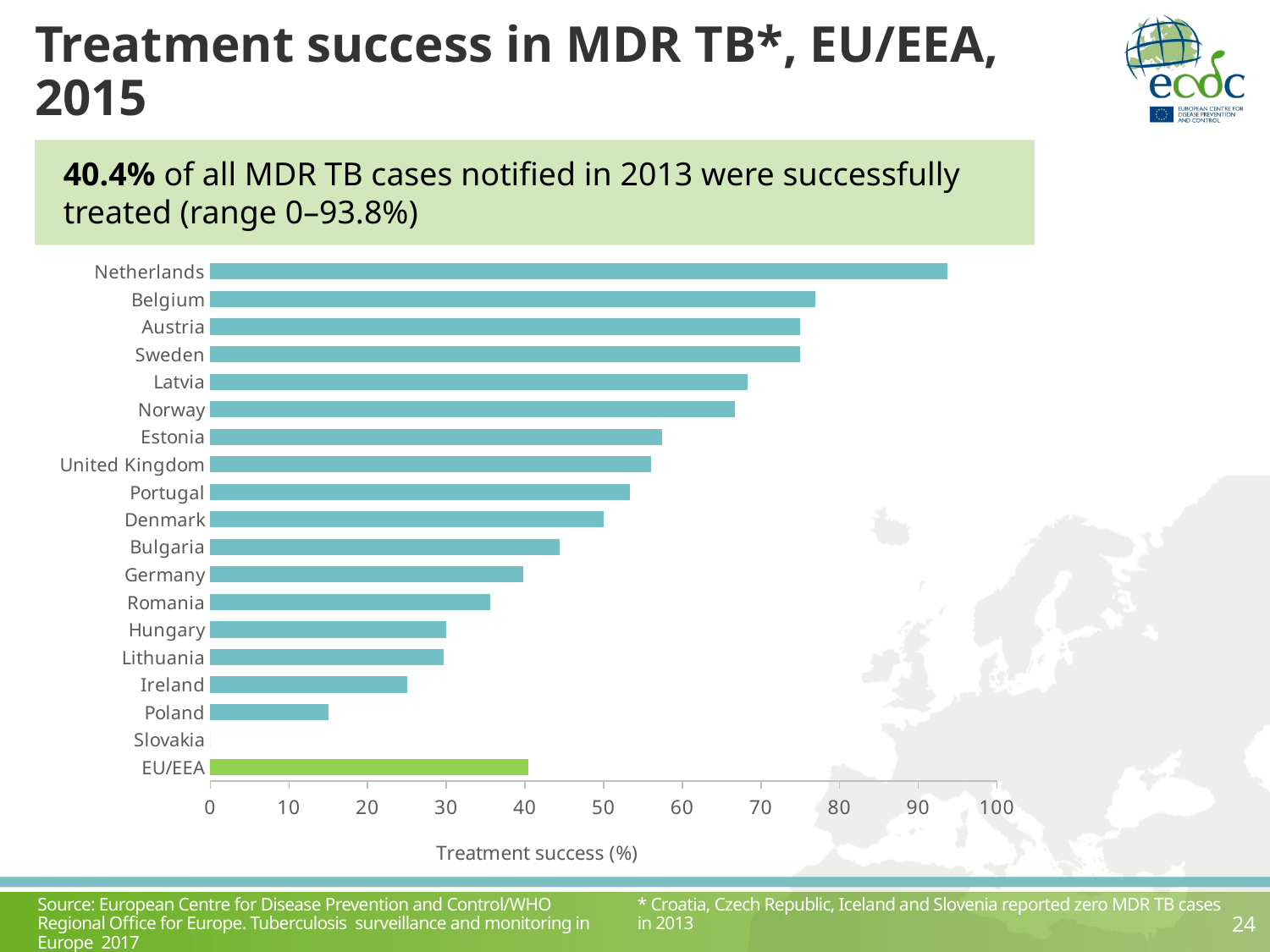
Which country has the lowest treatment success in the chart? Slovakia Which has a higher treatment success, Ireland or Poland? Ireland Is the treatment success value for Poland greater or less than 20? less What is the treatment success value for EU/EEA? 40.4% Is the treatment success value for Netherlands greater or less than 90? greater What is the title of the horizontal axis of the chart? Treatment success (%) Which country has the highest treatment success in the chart? Netherlands How many categories (bars) are listed on the chart's vertical axis? 19 Which has a higher treatment success, Belgium or Latvia? Belgium Is the treatment success value for Ireland greater or less than 30? less What type of chart is shown on the slide? bar chart